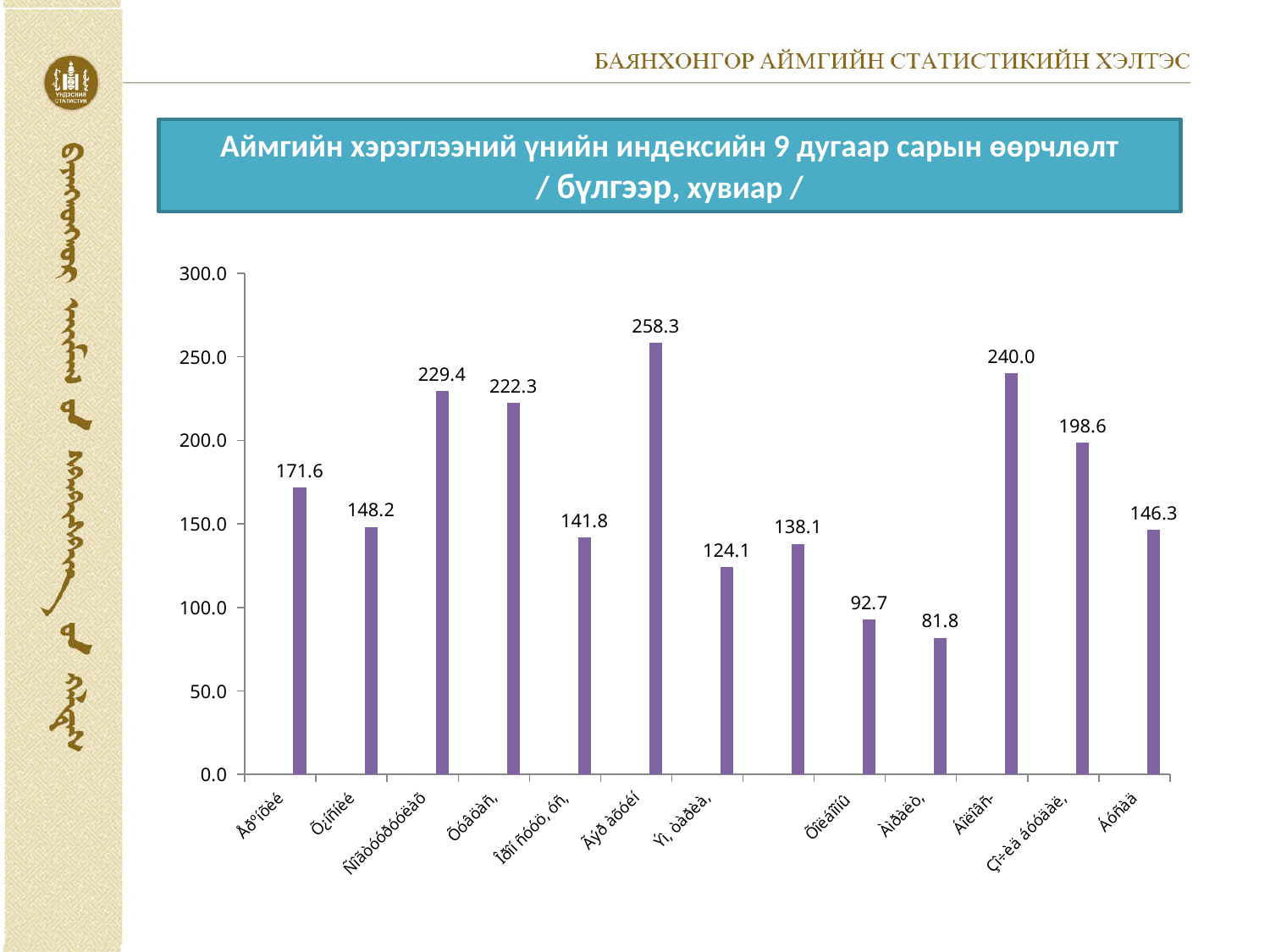
What is the maximum value shown on the vertical axis? 300.0 What is the value of the first bar from the left? 171.6 What is the value of the last bar on the right? 146.3 Is the value of the second bar from the left greater or less than 150? less What is the highest value shown on the chart? 258.3 What is the difference between the highest bar (258.3) and the lowest bar (81.8)? 176.5 What is the difference between the eleventh bar (240.0) and the twelfth bar (198.6)? 41.4 What is the lowest value shown on the chart? 81.8 What kind of chart is shown on the slide? bar chart Which is larger: the third bar from the left (229.4) or the fourth bar from the left (222.3)? the third bar (229.4) What is the value of the third bar from the left? 229.4 How many bars are plotted on the chart? 13